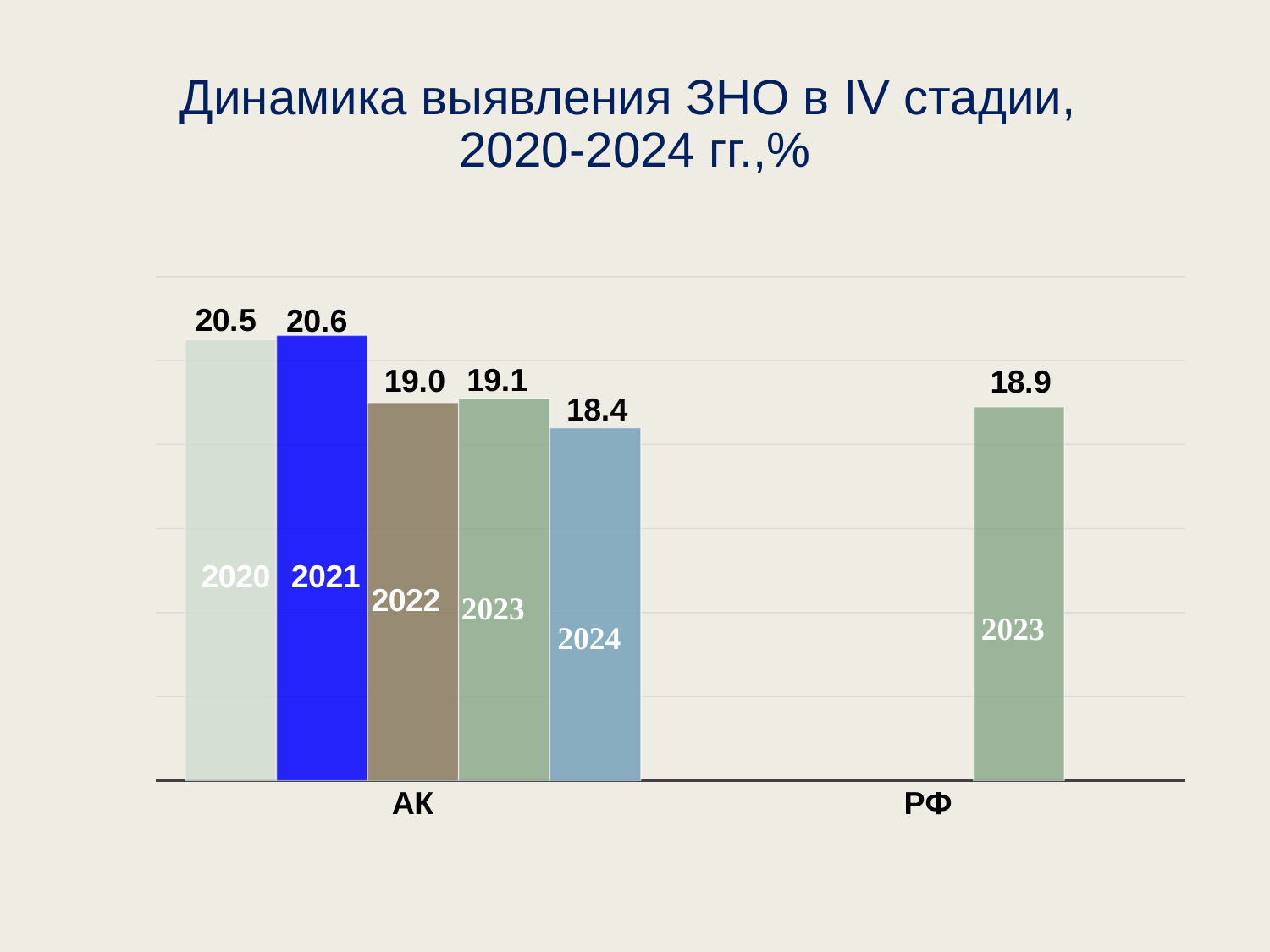
Which year has the lowest value in the АК group? 2024 How many bars are shown in the АК group? 5 What is the value for 2020 in the АК group? 20.5 What is the value for 2021 in the АК group? 20.6 What kind of chart is shown on the slide? Bar chart What is the value for 2023 in the РФ group? 18.9 What is the difference between the АК 2021 value and the АК 2024 value? 2.2 Which is larger: the АК 2023 value or the РФ 2023 value? АК 2023 Do the АК values generally rise or fall from 2020 to 2024? Fall Which year has the highest value in the АК group? 2021 What is the title of the chart? Динамика выявления ЗНО в IV стадии, 2020-2024 гг.,% What is the value for 2024 in the АК group? 18.4